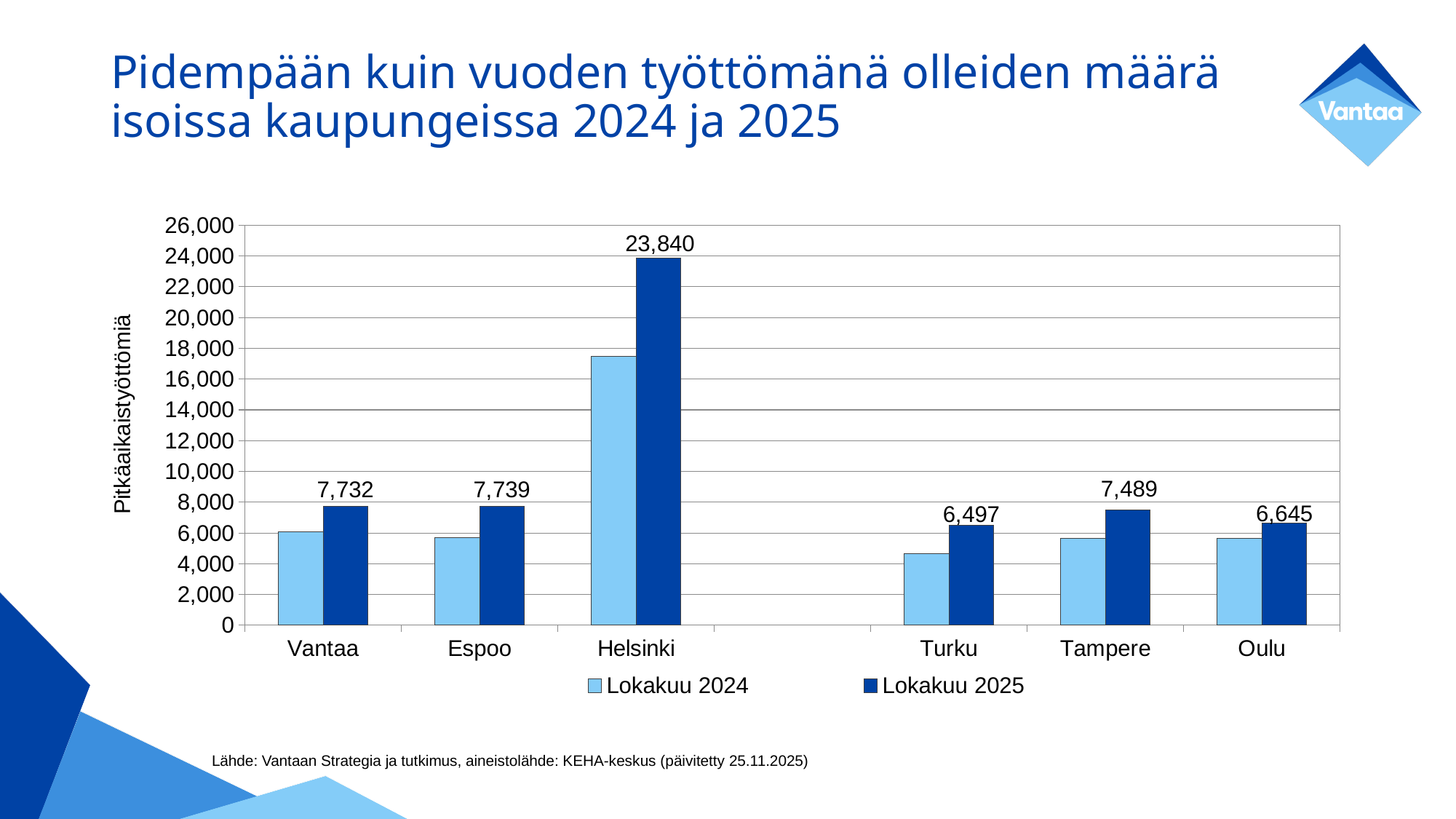
Which city has the highest value in the Lokakuu 2025 series? Helsinki What is the value for Turku in the Lokakuu 2025 series? 6,497 How many series does the legend list? 2 What is the value for Tampere in the Lokakuu 2025 series? 7,489 What is the difference between the Lokakuu 2025 values for Helsinki and Vantaa? 16,108 Which is larger for Helsinki: the Lokakuu 2024 value or the Lokakuu 2025 value? Lokakuu 2025 What is the difference between the Lokakuu 2025 values for Tampere and Oulu? 844 Is the Lokakuu 2024 value for Helsinki greater or less than 16,000? greater How many cities are shown on the x axis of the chart? 6 Is the Lokakuu 2024 value for Turku greater or less than 6,000? less What is the value for Helsinki in the Lokakuu 2025 series? 23,840 Which city has the lowest value in the Lokakuu 2025 series? Turku